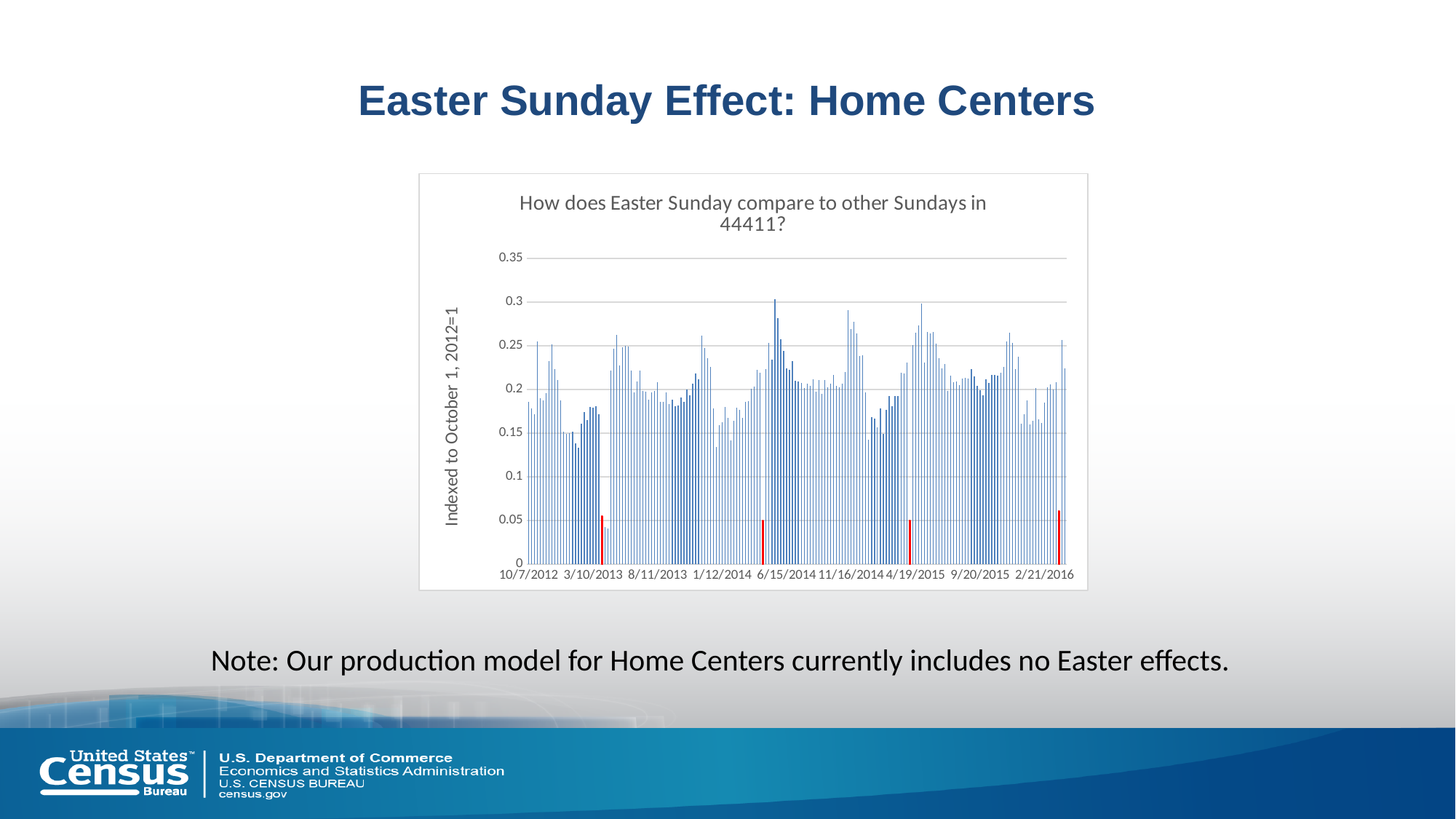
What is the label on the vertical axis of the chart? Indexed to October 1, 2012=1 Is the value of the red bar near 2/21/2016 greater or less than 0.1? less Are the red bars in the chart taller or shorter than the blue bars around them? shorter What is the title of the chart? How does Easter Sunday compare to other Sundays in 44411? What is the last date label on the horizontal axis of the chart? 2/21/2016 Is the tallest blue bar in the chart greater or less than 0.25? greater What is the first date label on the horizontal axis of the chart? 10/7/2012 Is the tallest bar in the chart greater or less than 0.35? less How many red bars are shown in the chart? 4 What kind of chart is shown on the slide? Bar chart What is the highest value shown on the vertical axis of the chart? 0.35